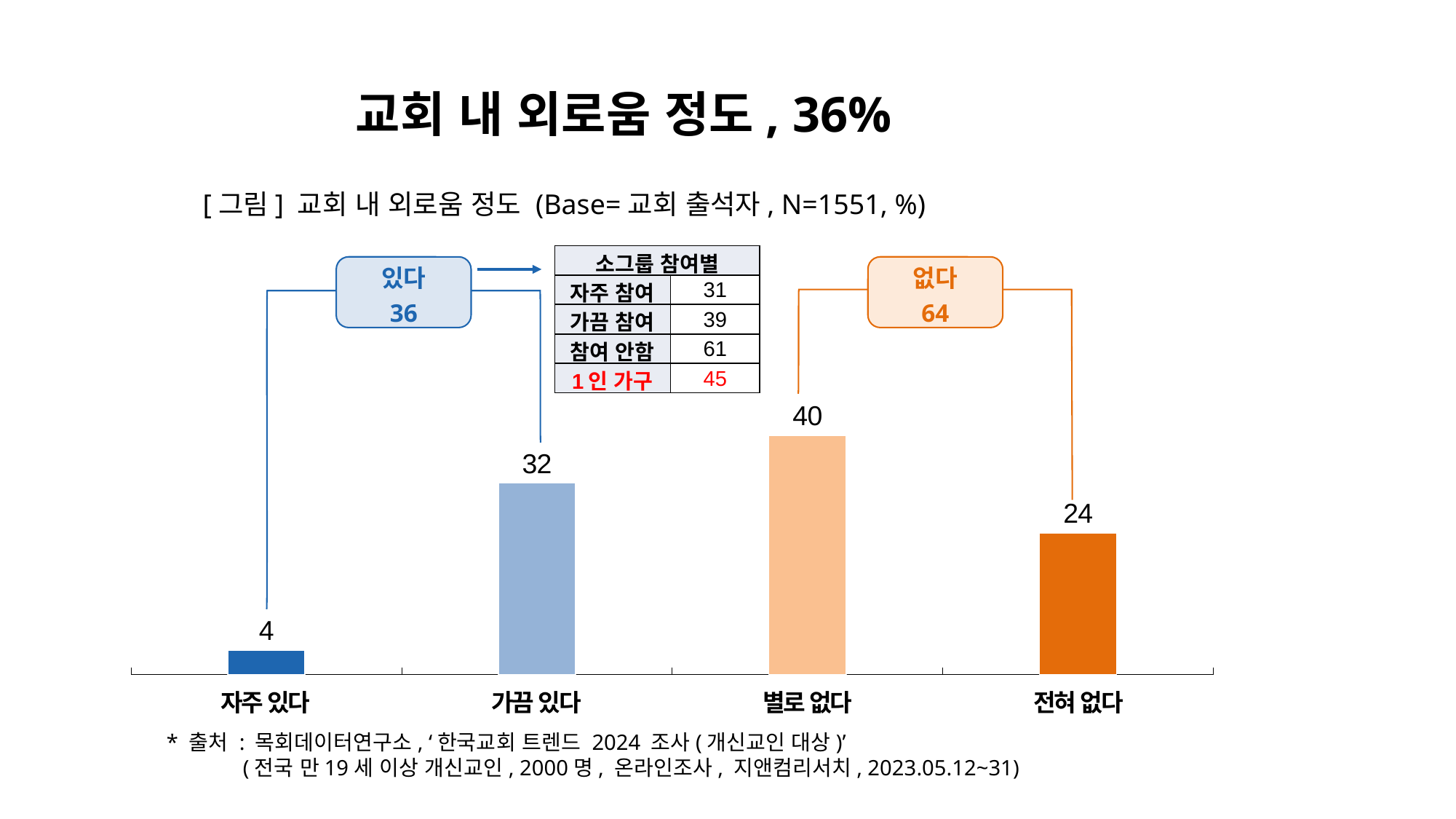
What is the value for 가끔 있다? 32 What is the value for 전혀 없다? 24 Which category has the lowest value? 자주 있다 Which category has the highest value? 별로 없다 What is the value for 자주 있다? 4 How many categories are shown on the x axis? 4 What is the difference between the values for 별로 없다 and 가끔 있다? 8 What kind of chart is shown on the slide? bar chart What is the combined value shown in the 없다 box? 64 Which is larger, the value for 가끔 있다 or the value for 전혀 없다? 가끔 있다 What is the value for 별로 없다? 40 What is the combined value shown in the 있다 box? 36